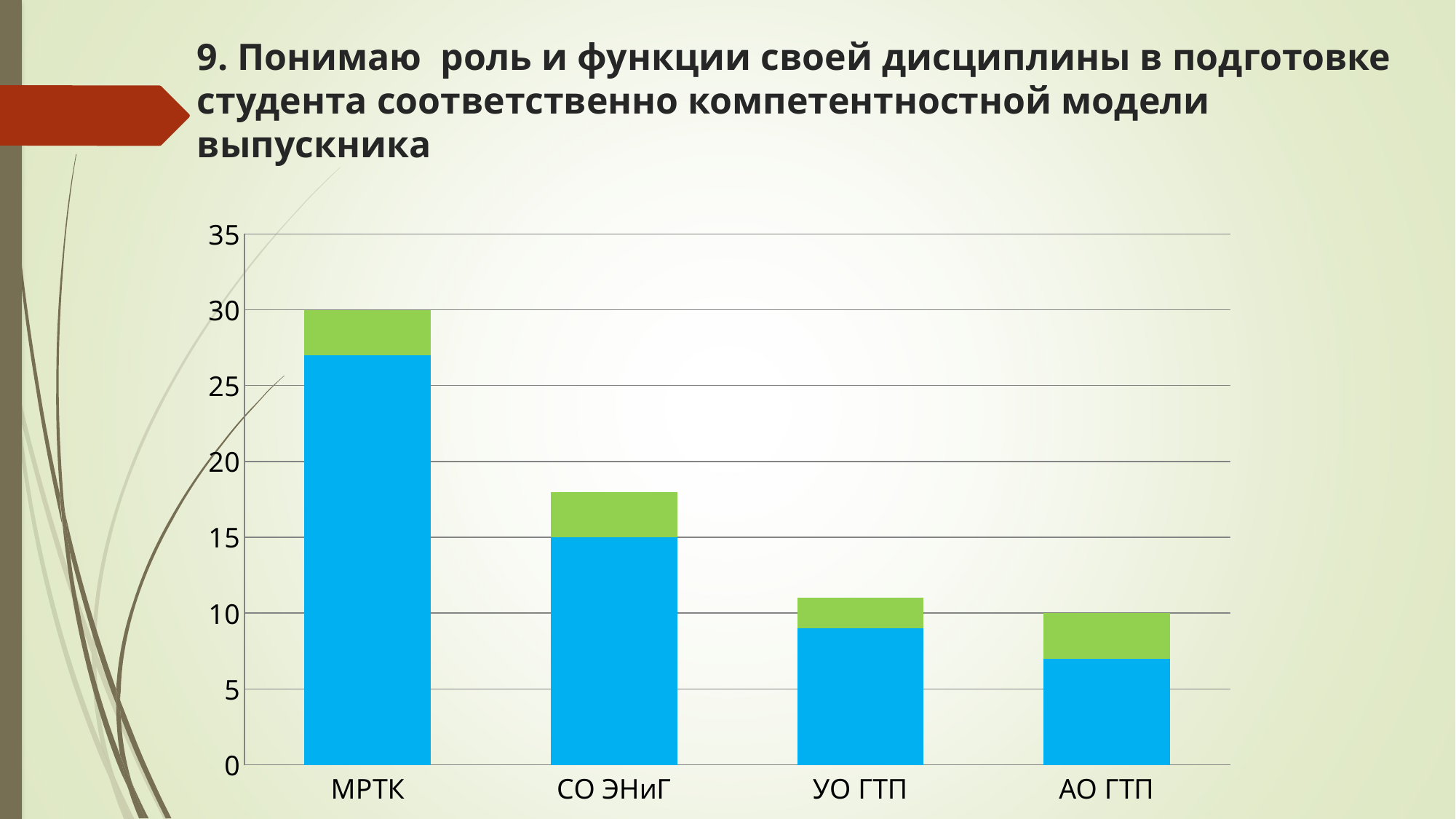
How many categories are shown on the x axis of the chart? 4 What is the total height of the stacked bar for АО ГТП? 10 What is the total height of the stacked bar for МРТК? 30 Is the total value for УО ГТП greater or less than 10? greater Do the bar heights rise or fall from left to right across the x axis? fall Is the total value for СО ЭНиГ greater or less than 20? less What kind of chart is shown on the slide? stacked bar chart What two colours are used for the segments of each stacked bar? blue and green Is the blue segment for МРТК greater or less than 25? greater Which category has the shortest bar in the chart? АО ГТП Which bar is taller, СО ЭНиГ or УО ГТП? СО ЭНиГ Which category has the tallest bar in the chart? МРТК